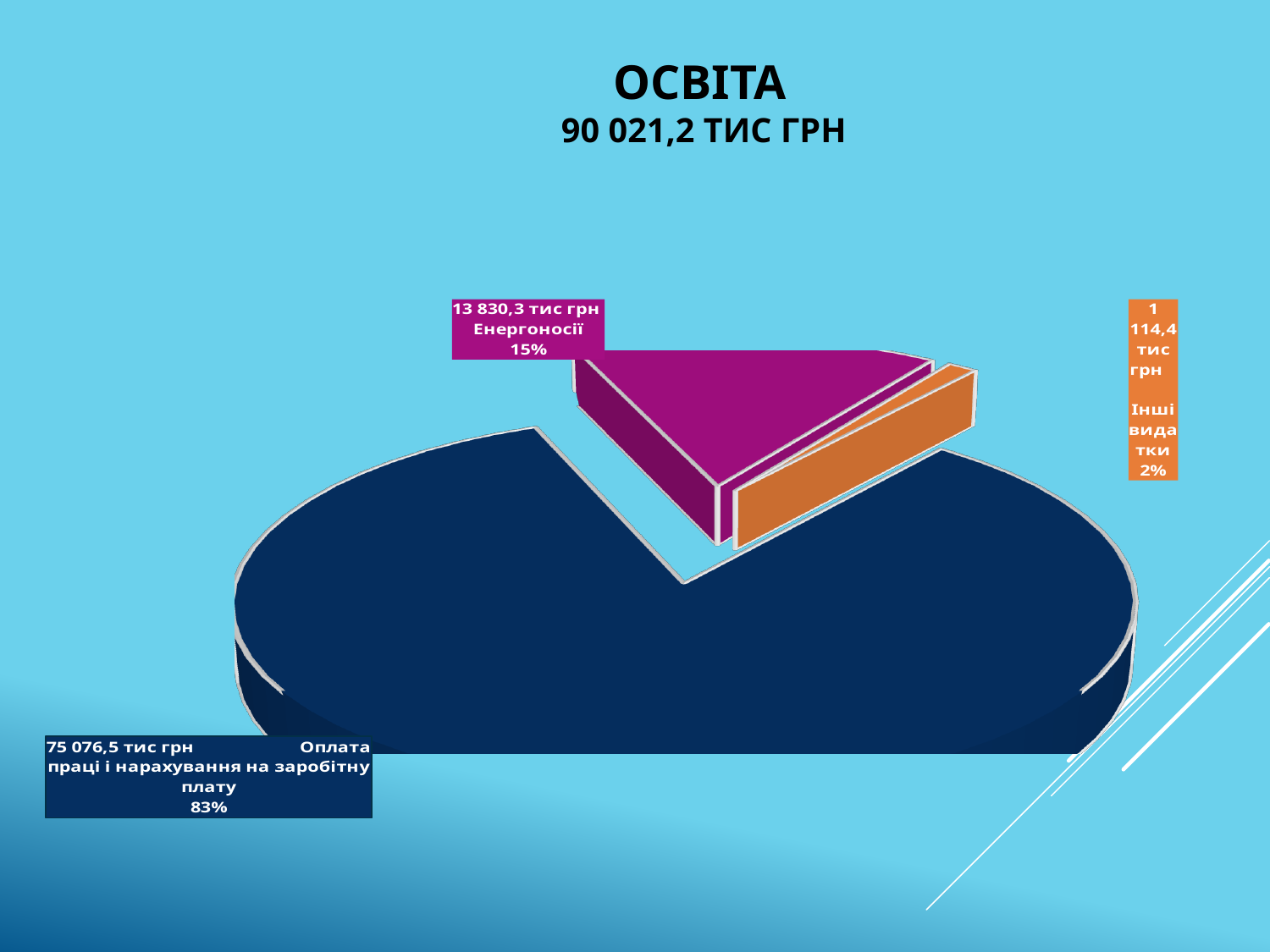
What total amount is shown under the chart title ОСВІТА? 90 021,2 тис грн Which category has the largest slice? Оплата праці і нарахування на заробітну плату What is the value for Оплата праці і нарахування на заробітну плату? 75 076,5 тис грн What share of the pie does Оплата праці і нарахування на заробітну плату take? 83% Which category has the smallest slice? Інші видатки How many slices does the pie chart have? 3 What share of the pie does Енергоносії take? 15% What share of the pie does Інші видатки take? 2% Which is larger, Енергоносії or Інші видатки? Енергоносії What kind of chart is shown on the slide? pie chart What is the value for Енергоносії? 13 830,3 тис грн What is the value for Інші видатки? 1 114,4 тис грн